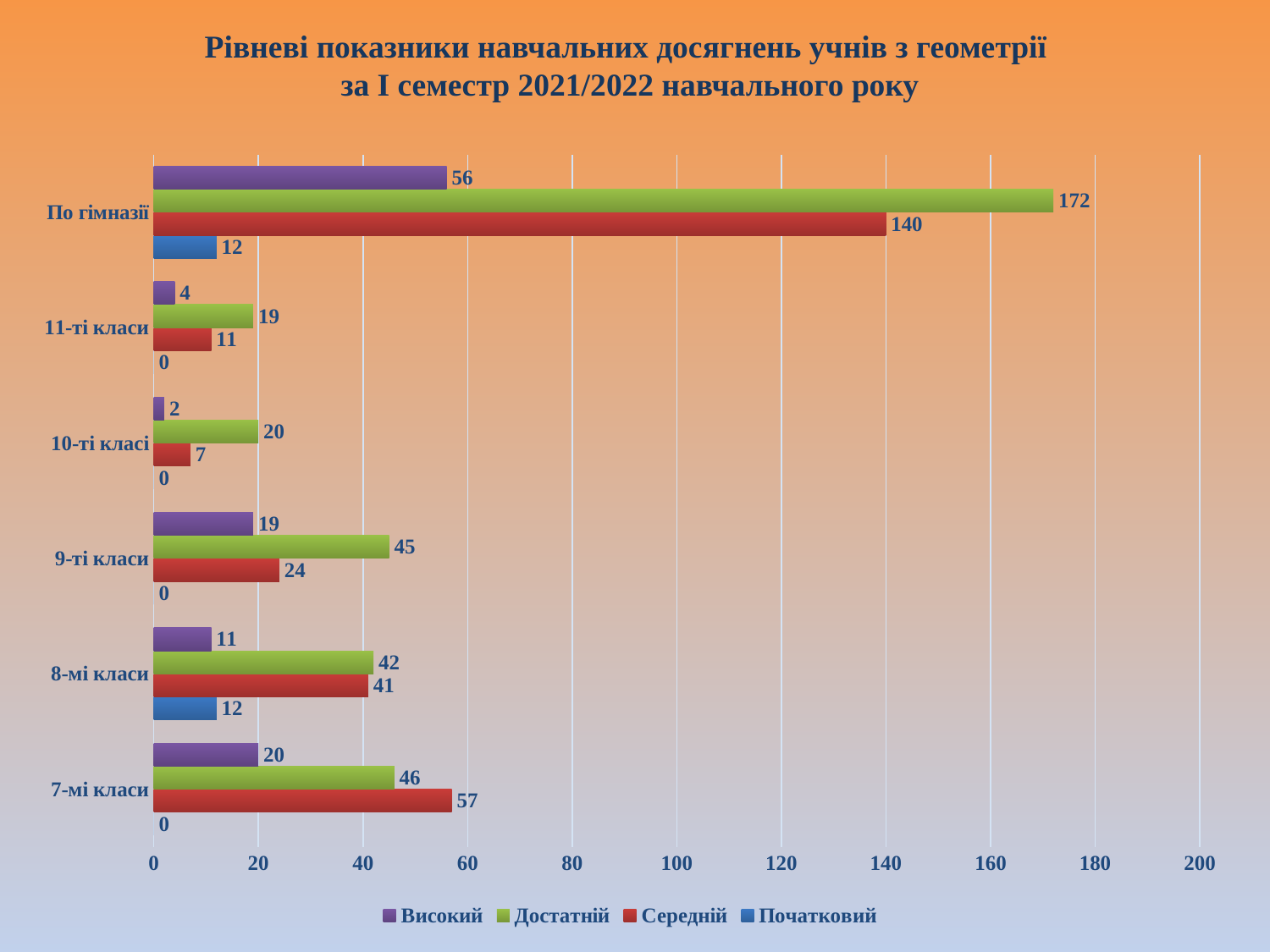
Which series is shown in green in the legend? Достатній What is the value of Початковий for 8-мі класи? 12 What is the value of Високий for 9-ті класи? 19 Which is larger for 8-мі класи: Достатній or Середній? Достатній How many categories are shown on the y axis? 6 What kind of chart is shown on the slide? Bar chart Which category has the highest value for Середній? По гімназії What is the value of Достатній for По гімназії? 172 Among the class categories (excluding По гімназії), which has the lowest value for Високий? 10-ті класі What is the value of Середній for 7-мі класи? 57 What is the difference between Достатній and Середній for По гімназії? 32 How many series does the legend list? 4